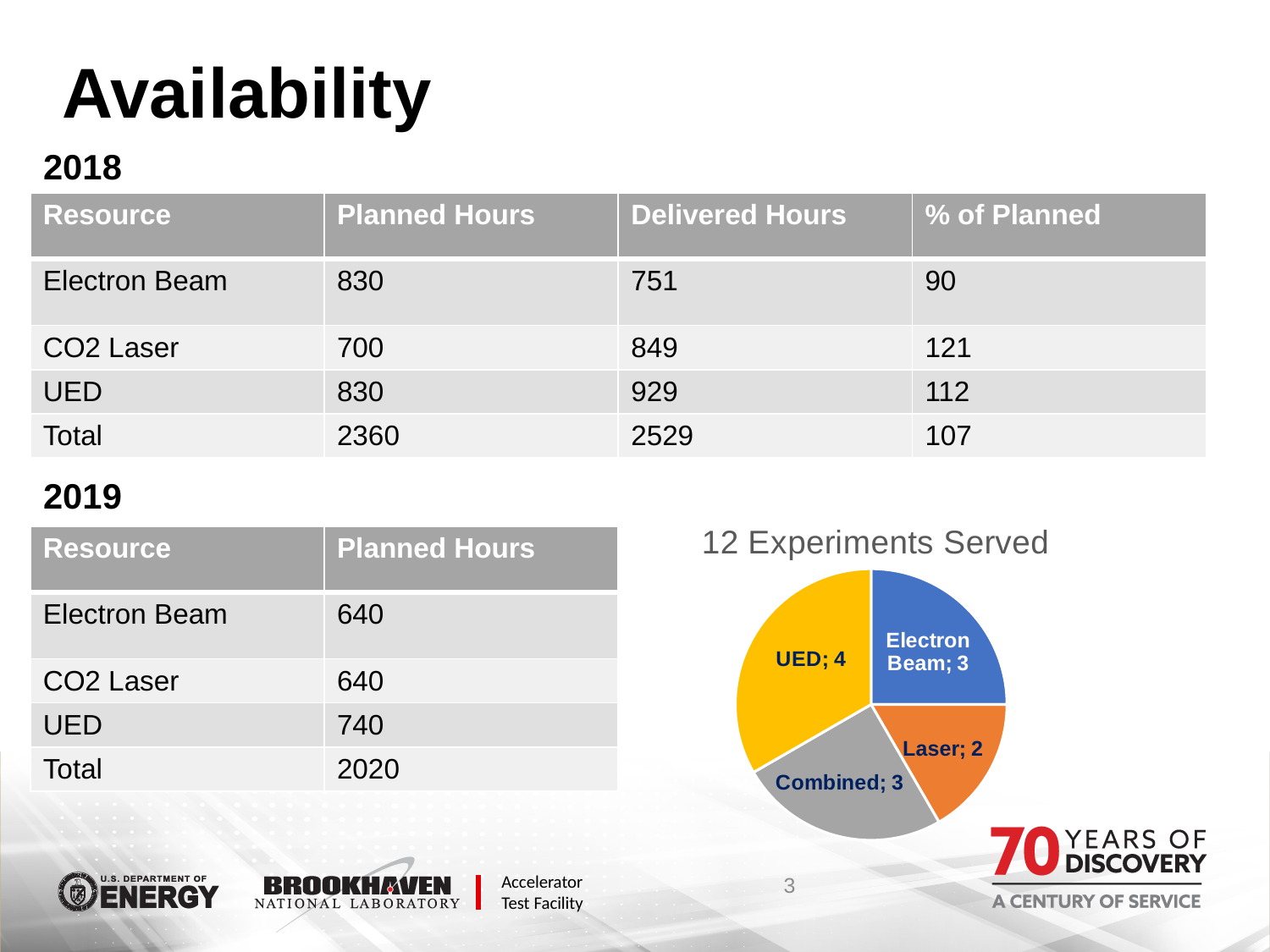
In the pie chart, which is larger, the UED slice or the Laser slice? UED How many experiments does the Laser slice represent in the pie chart? 2 What kind of chart is shown on the slide? pie chart How many experiments does the UED slice represent in the pie chart? 4 How many experiments does the Electron Beam slice represent in the pie chart? 3 How many experiments does the Combined slice represent in the pie chart? 3 In the pie chart, how many more experiments does UED have than Laser? 2 How many slices does the pie chart have? 4 What is the title of the pie chart? 12 Experiments Served Which category has the smallest slice in the pie chart? Laser Which category has the largest slice in the pie chart? UED What colour is the UED slice in the pie chart? yellow